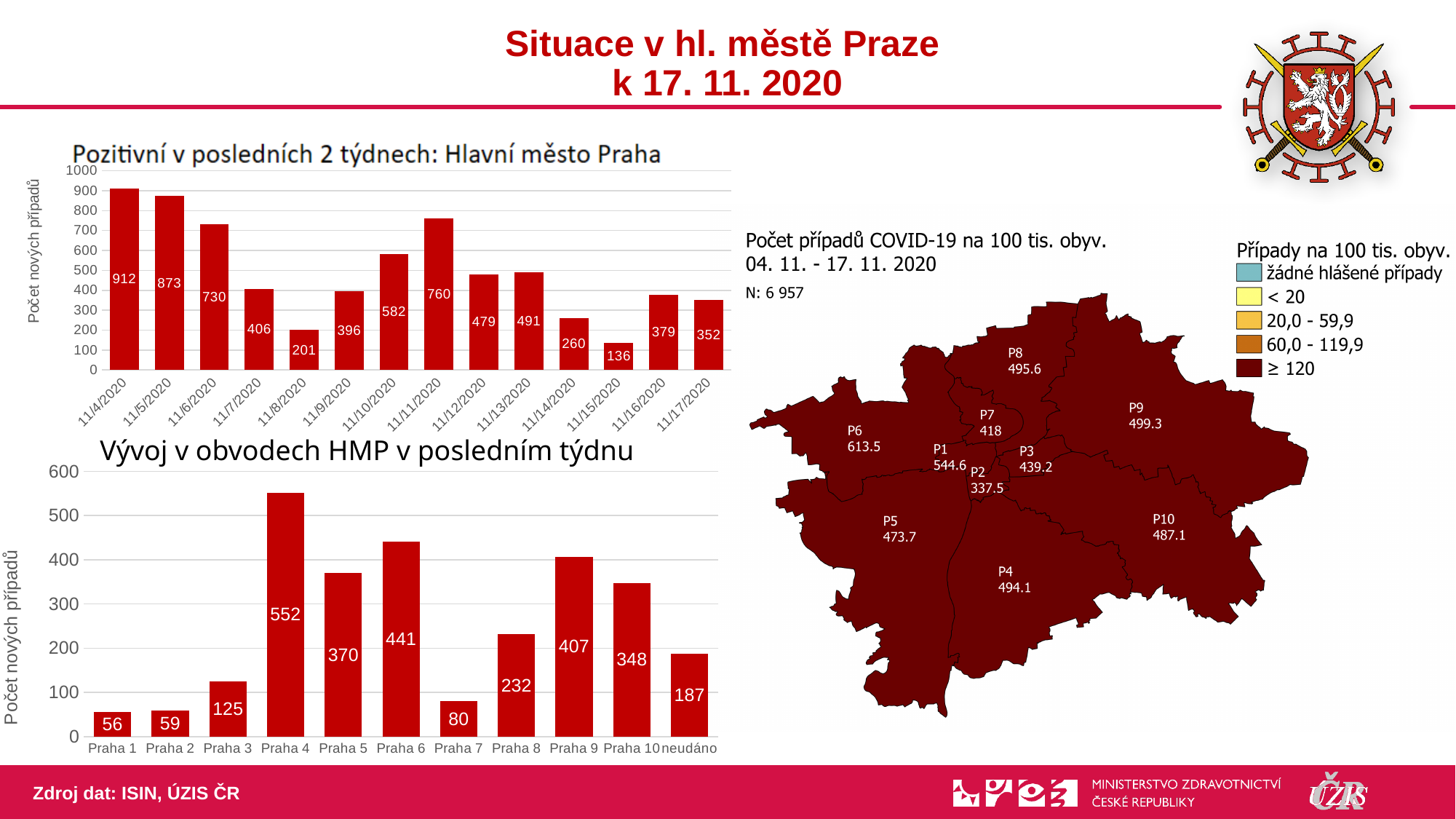
In the chart 'Pozitivní v posledních 2 týdnech: Hlavní město Praha', what is the difference between the values for 11/4/2020 and 11/5/2020? 39 In the chart 'Pozitivní v posledních 2 týdnech: Hlavní město Praha', is the value for 11/10/2020 greater or less than 500? greater In the chart 'Vývoj v obvodech HMP v posledním týdnu', which category has the lowest value? Praha 1 In the chart 'Pozitivní v posledních 2 týdnech: Hlavní město Praha', how many dates are shown on the x axis? 14 What kind of chart is 'Vývoj v obvodech HMP v posledním týdnu'? bar chart In the chart 'Vývoj v obvodech HMP v posledním týdnu', how many categories are shown on the x axis? 11 In the chart 'Vývoj v obvodech HMP v posledním týdnu', which category has the highest value? Praha 4 In the chart 'Vývoj v obvodech HMP v posledním týdnu', what is the value for Praha 6? 441 In the chart 'Vývoj v obvodech HMP v posledním týdnu', which is larger, the value for Praha 9 or the value for Praha 10? Praha 9 In the chart 'Pozitivní v posledních 2 týdnech: Hlavní město Praha', which date has the highest value? 11/4/2020 In the chart 'Pozitivní v posledních 2 týdnech: Hlavní město Praha', what is the value for 11/11/2020? 760 In the chart 'Pozitivní v posledních 2 týdnech: Hlavní město Praha', which date has the lowest value? 11/15/2020